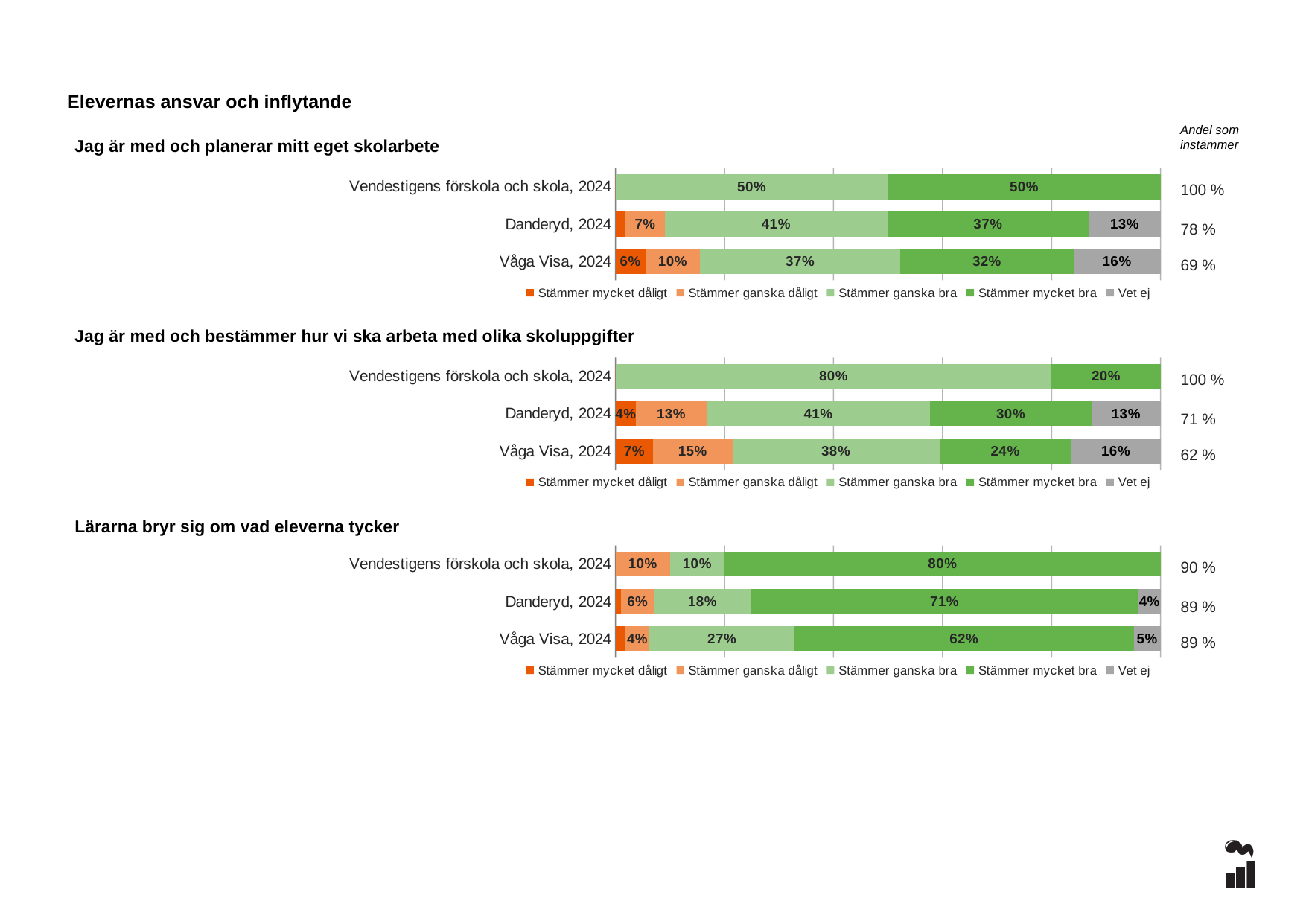
How many rows (categories) are shown in the chart "Jag är med och planerar mitt eget skolarbete"? 3 How many series does the legend list in the chart "Lärarna bryr sig om vad eleverna tycker"? 5 In the chart "Lärarna bryr sig om vad eleverna tycker", is the "Stämmer ganska bra" value larger for Danderyd, 2024 or Våga Visa, 2024? Våga Visa, 2024 In the chart "Lärarna bryr sig om vad eleverna tycker", which row has the highest "Stämmer mycket bra" value? Vendestigens förskola och skola, 2024 In the chart "Jag är med och planerar mitt eget skolarbete", what is the "Vet ej" value for Våga Visa, 2024? 16% In the chart "Lärarna bryr sig om vad eleverna tycker", what is the "Stämmer mycket bra" value for Våga Visa, 2024? 62% In the chart "Jag är med och planerar mitt eget skolarbete", what is the "Andel som instämmer" figure shown for Danderyd, 2024? 78 % In the chart "Jag är med och bestämmer hur vi ska arbeta med olika skoluppgifter", what is the "Stämmer ganska bra" value for Vendestigens förskola och skola, 2024? 80% In the chart "Jag är med och planerar mitt eget skolarbete", what is the "Stämmer mycket bra" value for Danderyd, 2024? 37% In the chart "Jag är med och bestämmer hur vi ska arbeta med olika skoluppgifter", what is the difference between the "Stämmer mycket bra" values for Danderyd, 2024 and Våga Visa, 2024? 6% What kind of chart is "Jag är med och bestämmer hur vi ska arbeta med olika skoluppgifter"? Stacked bar chart In the chart "Jag är med och bestämmer hur vi ska arbeta med olika skoluppgifter", which row has the lowest "Andel som instämmer" figure? Våga Visa, 2024